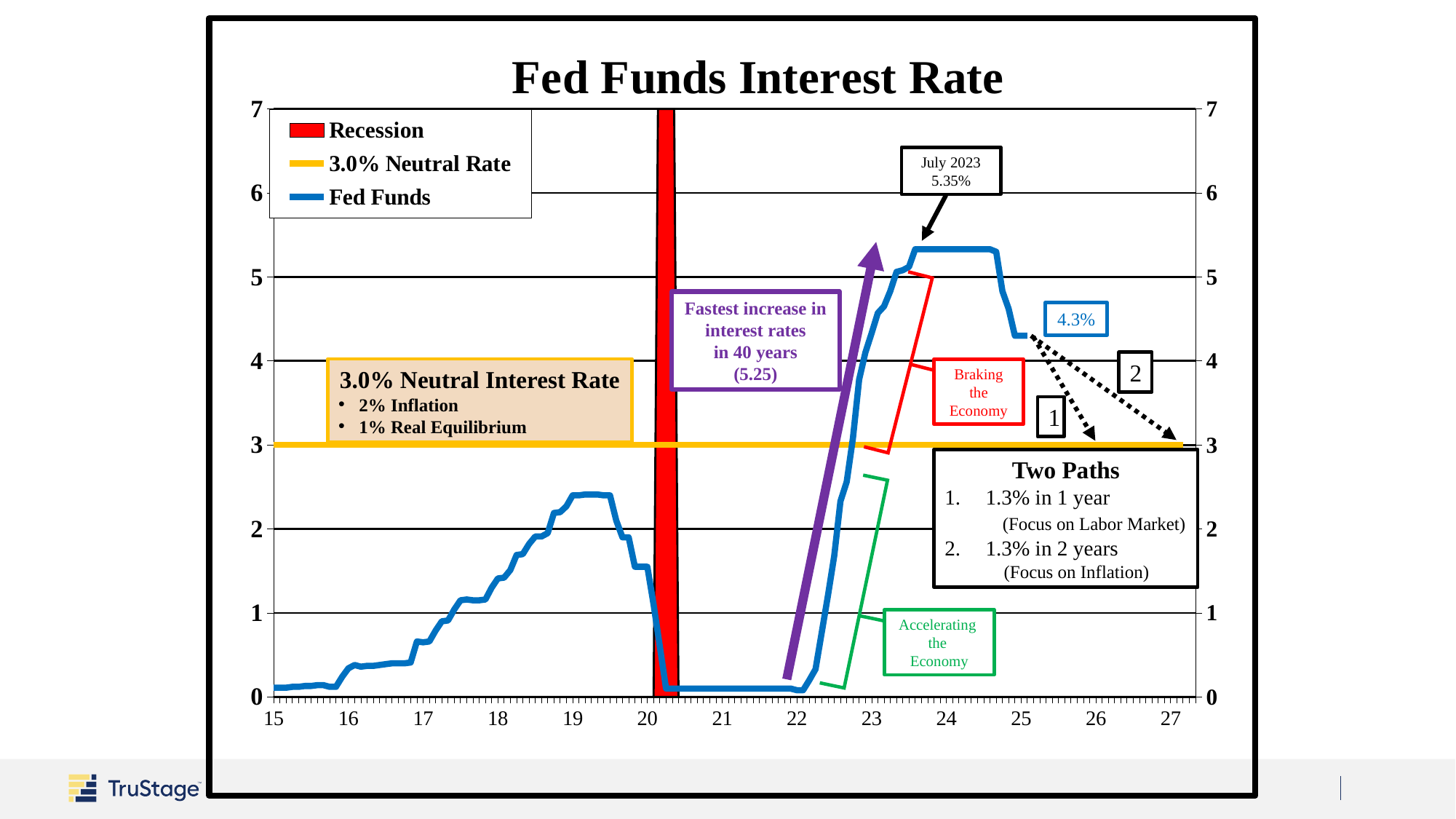
Is the Fed Funds rate at year 21 greater or less than 1? less What is the difference between the labeled July 2023 rate of 5.35% and the later labeled rate of 4.3%? 1.05% What value is labeled on the Fed Funds line at the end of the plotted data, around year 25? 4.3% Does the Fed Funds line rise or fall between year 22 and year 23? rise What Fed Funds rate is labeled for July 2023? 5.35% How many entries does the chart's legend list? 3 What is the neutral interest rate shown by the yellow horizontal line? 3.0% Does the Fed Funds line rise or fall between year 24.5 and year 25? fall Which is larger, the labeled Fed Funds rate for July 2023 or the labeled rate of 4.3% near year 25? July 2023 (5.35%) Is the Fed Funds rate at year 19 greater or less than 2? greater What is the title of the chart? Fed Funds Interest Rate What kind of chart is shown on the slide? Line chart